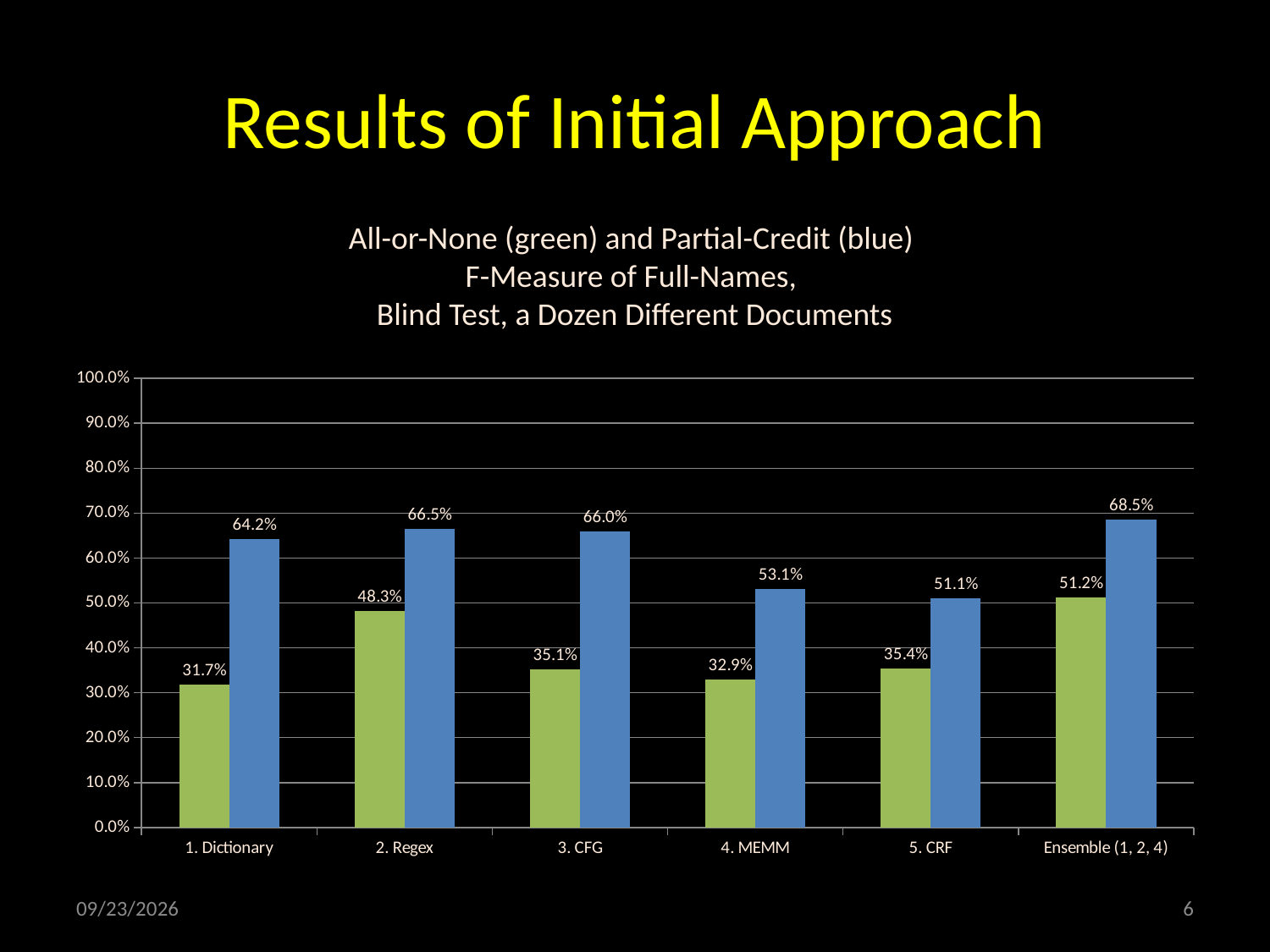
How many categories are shown on the x axis of the chart? 6 Which category has the lowest Partial-Credit (blue) F-measure? 5. CRF What is the All-or-None (green) F-measure for 1. Dictionary? 31.7% What is the Partial-Credit (blue) value for Ensemble (1, 2, 4)? 68.5% Which category has the lowest All-or-None (green) F-measure? 1. Dictionary What is the difference between the Partial-Credit (blue) and All-or-None (green) values for 1. Dictionary? 32.5 percentage points Is the Partial-Credit (blue) value for 2. Regex greater or less than 60.0%? greater What kind of chart is shown on the slide? Bar chart Which has a higher All-or-None (green) value, 2. Regex or 3. CFG? 2. Regex Which category has the highest All-or-None (green) F-measure? Ensemble (1, 2, 4) According to the slide, which colour represents the Partial-Credit F-measure? Blue What is the Partial-Credit (blue) F-measure for 3. CFG? 66.0%